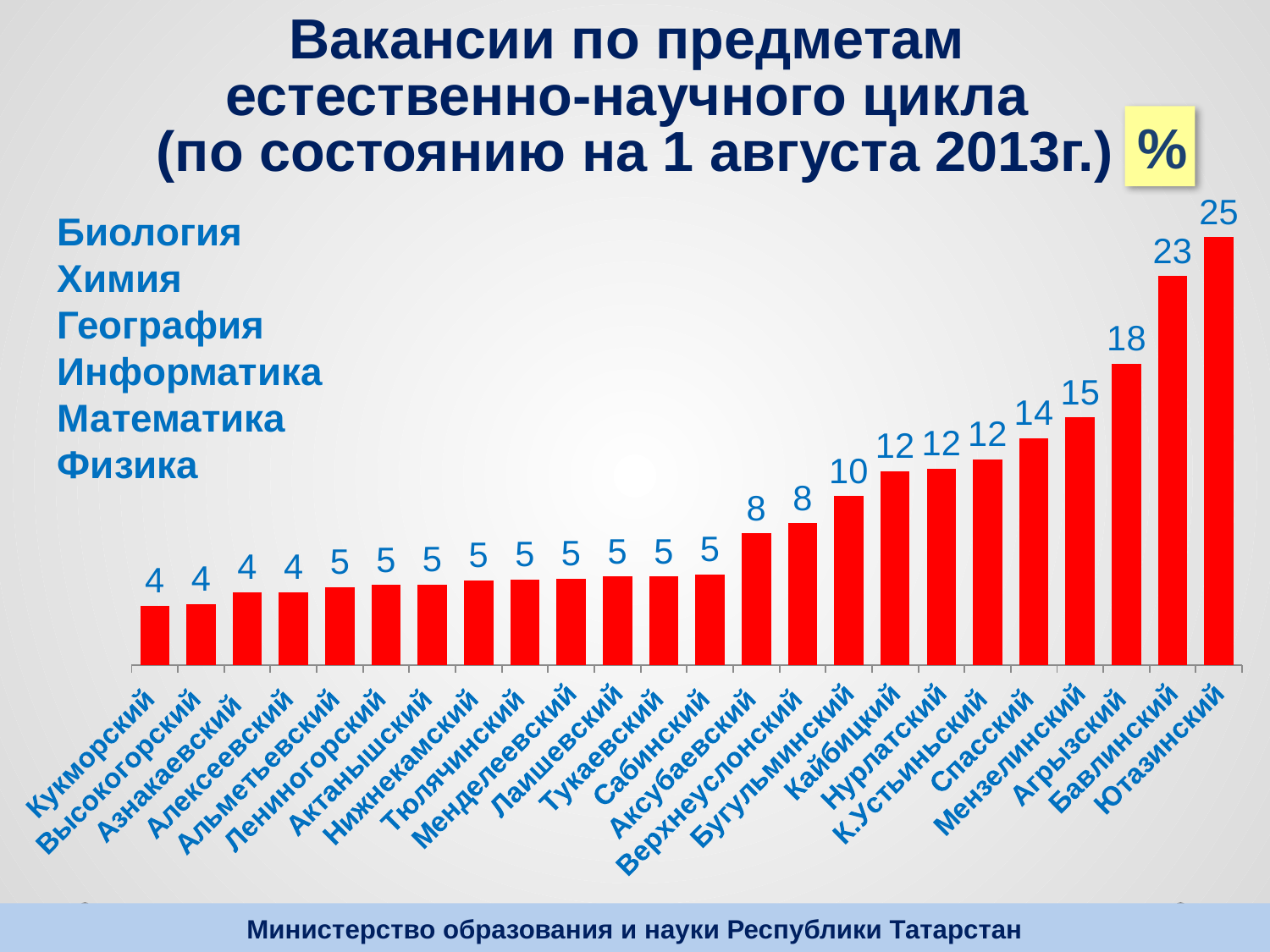
How many bars have the value 12? 3 What is the value for Азнакаевский? 4 Do the values generally rise or fall from left to right along the x axis? rise Which district has the highest value on the chart? Ютазинский What is the value for Кукморский? 4 What is the value for Ютазинский? 25 Which is larger, the value for Ютазинский or the value for Кукморский? Ютазинский What is the lowest value shown on the chart? 4 What is the difference between the values for Ютазинский and Бавлинский? 2 What type of chart is shown on the slide? bar chart What is the value for Бавлинский? 23 What unit is indicated in the yellow box next to the title? %